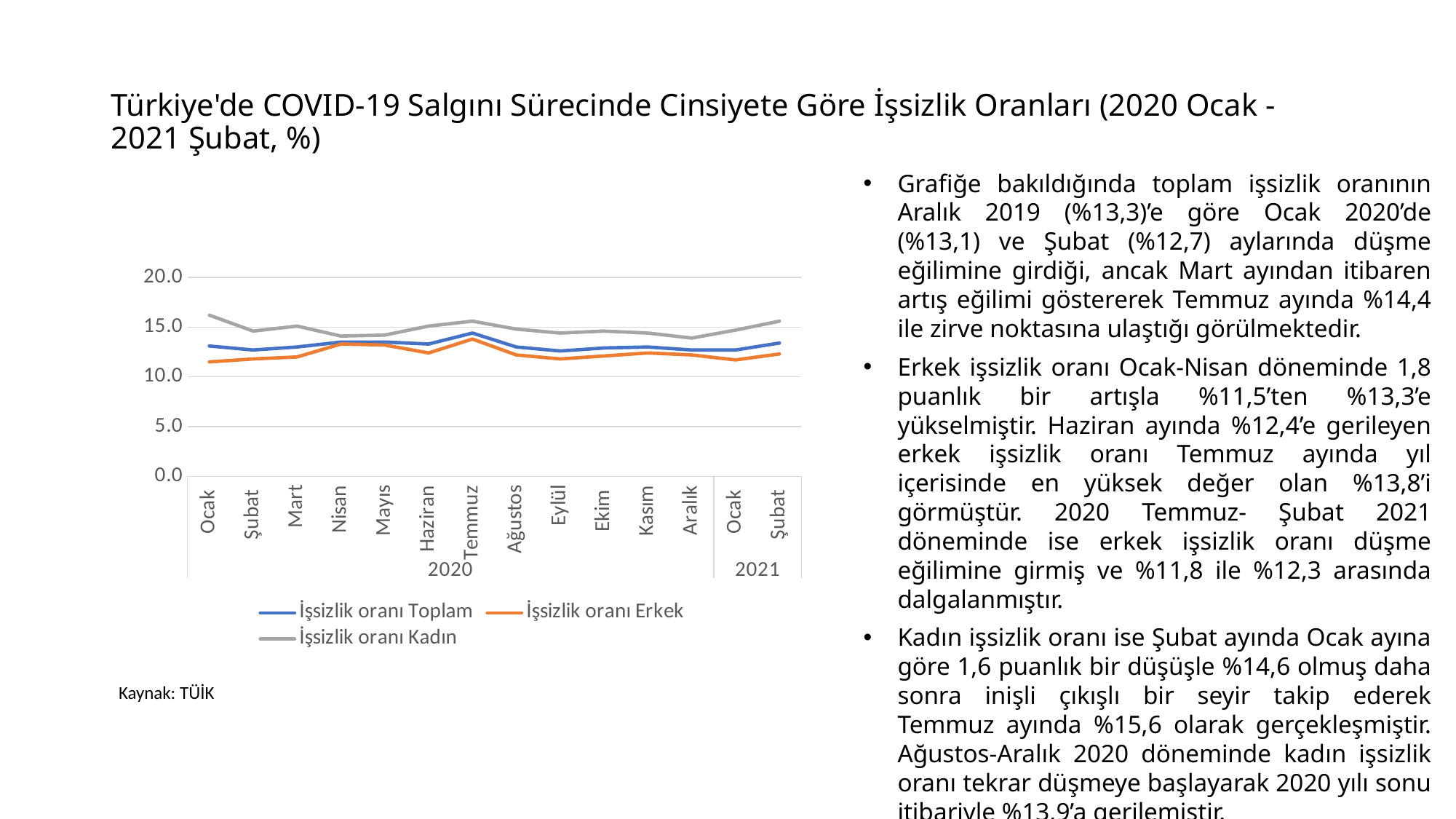
Does the İşsizlik oranı Erkek line rise or fall from Ocak 2020 to Nisan 2020? rise What kind of chart is shown on the slide? line chart In Ocak 2020, which is larger: İşsizlik oranı Kadın or İşsizlik oranı Erkek? İşsizlik oranı Kadın Is the value for İşsizlik oranı Kadın in Ocak 2020 greater or less than 15.0? greater How many series does the chart legend list? 3 Is the value for İşsizlik oranı Toplam in Temmuz 2020 greater or less than 10.0? greater Is the value for İşsizlik oranı Erkek in Ocak 2020 greater or less than 15.0? less Which series has the lowest values across the whole period? İşsizlik oranı Erkek What source is cited below the chart? TÜİK Which series has the highest values across the whole period? İşsizlik oranı Kadın How many months (data points) are plotted along the x axis? 14 Does the İşsizlik oranı Kadın line rise or fall from Ocak 2020 to Şubat 2020? fall